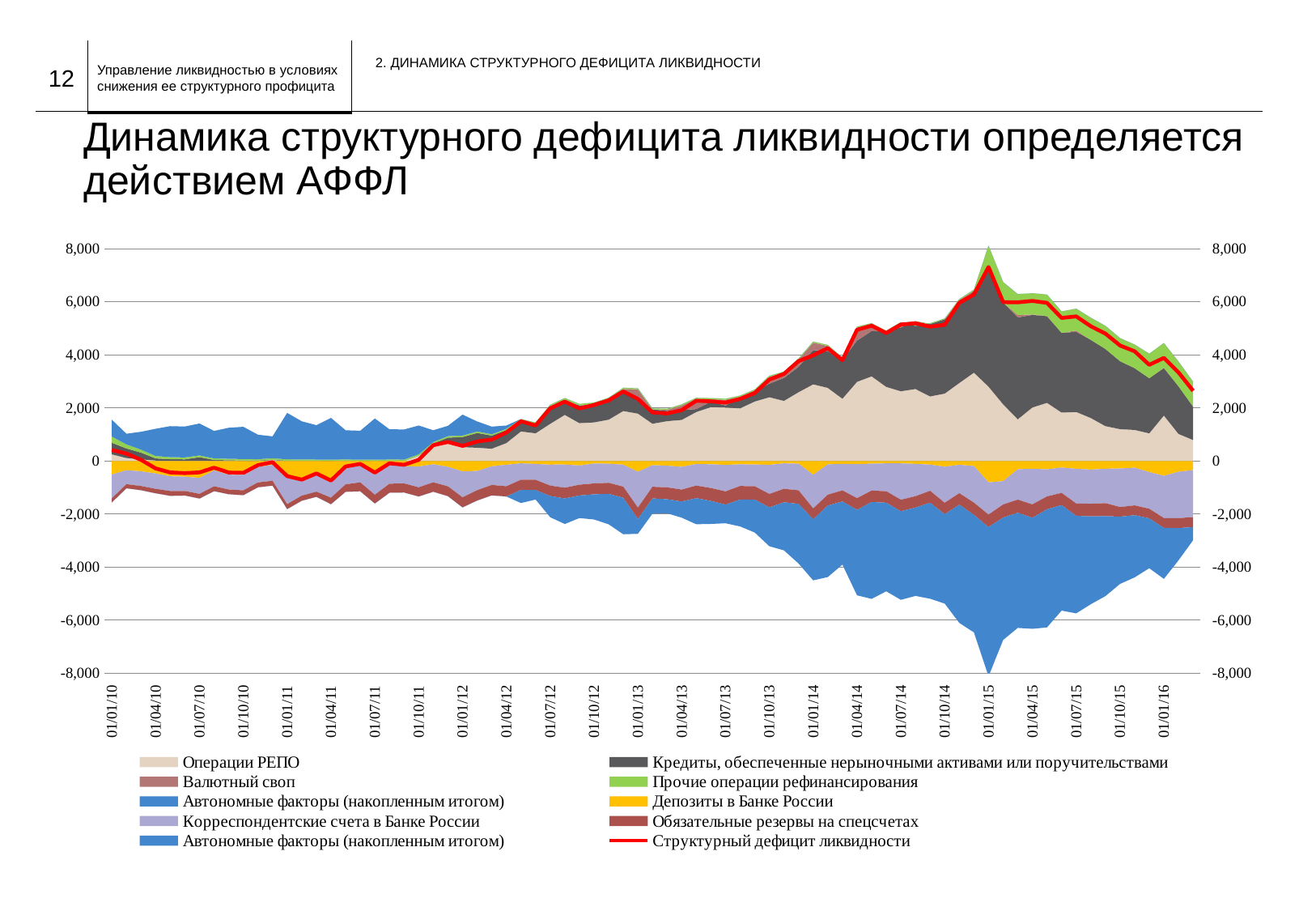
How many entries does the chart legend list? 10 Is the value of the red line 'Структурный дефицит ликвидности' at 01/01/13 greater or less than 2,000? greater Does the red line 'Структурный дефицит ликвидности' rise or fall between 01/01/15 and the end of the chart? fall Is the value of the red line 'Структурный дефицит ликвидности' at 01/04/11 greater or less than 0? less What colour is the line for 'Структурный дефицит ликвидности' in the chart? Red Is the value of the red line 'Структурный дефицит ликвидности' at 01/01/10 greater or less than 2,000? less How many date labels are shown along the x axis? 25 What kind of chart is shown on the slide? Stacked area chart with a line Around which date does the red line 'Структурный дефицит ликвидности' reach its highest value? 01/01/15 Does the red line 'Структурный дефицит ликвидности' generally rise or fall between 01/01/12 and 01/01/15? rise